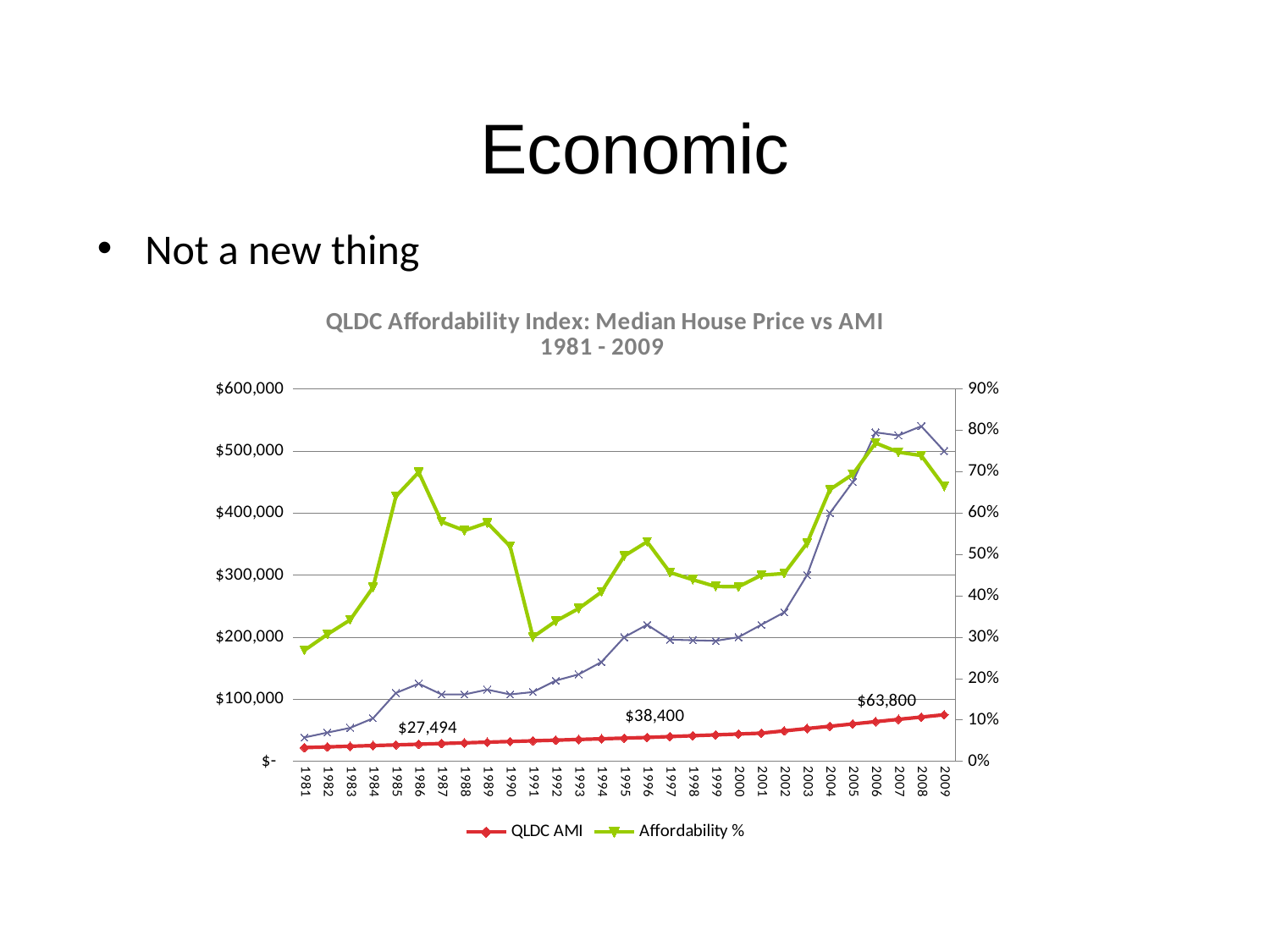
What is the leftmost data label printed on the QLDC AMI line? $27,494 What is the rightmost data label printed on the QLDC AMI line? $63,800 Which year has the higher Affordability % value, 1981 or 2009? 2009 Is the QLDC AMI value for 2009 greater or less than $100,000? less What kind of chart is shown on the slide? line chart How many series does the chart legend list? 2 Is the Affordability % value for 1991 greater or less than 40%? less How many years are plotted along the x axis of the chart? 29 What is the title of the chart? QLDC Affordability Index: Median House Price vs AMI 1981 - 2009 Does the QLDC AMI series rise or fall from 1981 to 2009? rise In which year does the Affordability % series reach its highest value? 2006 Is the Affordability % value for 1986 greater or less than 60%? greater